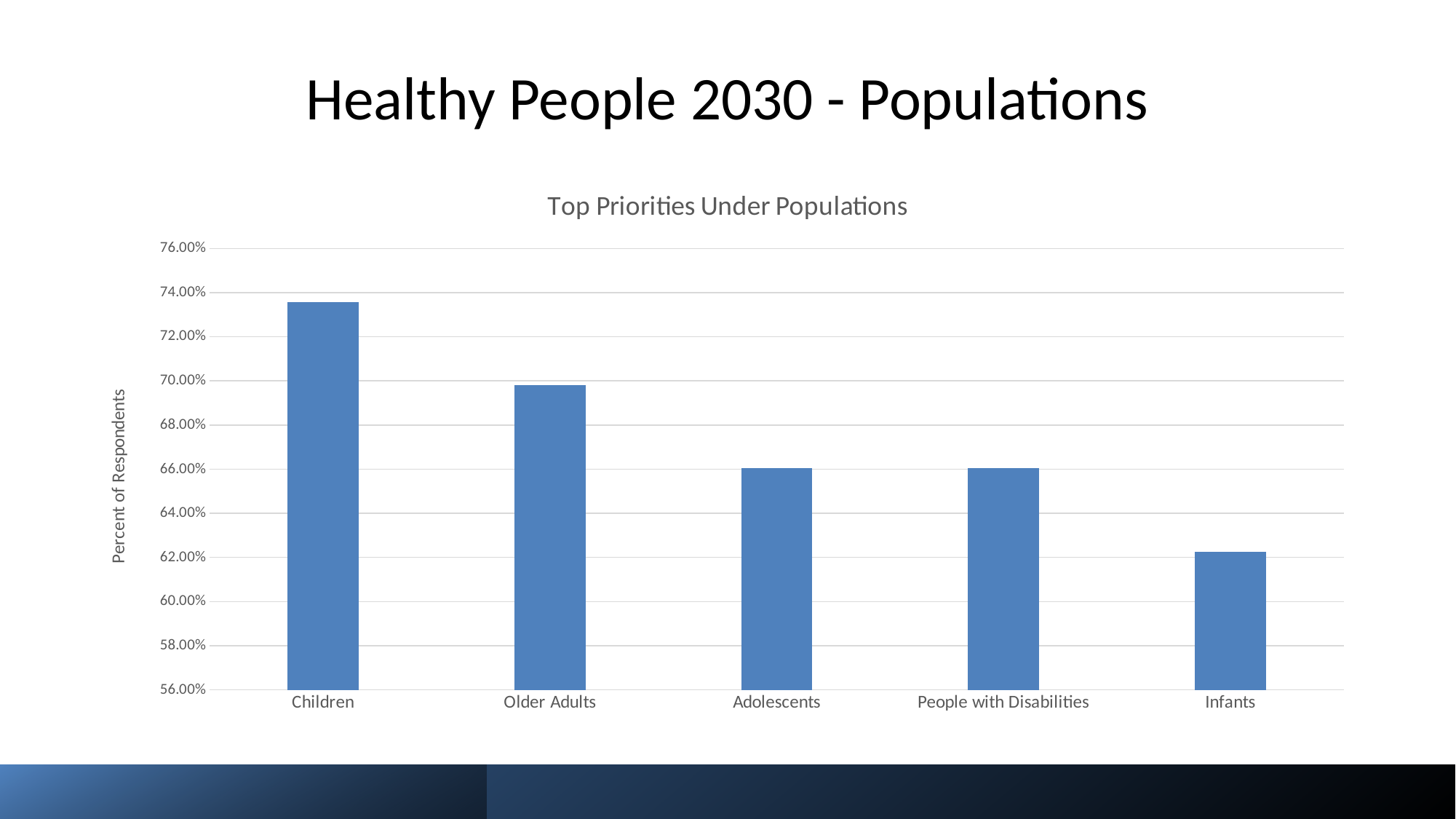
What is the label on the vertical axis of the chart? Percent of Respondents Which population has the highest percent of respondents? Children Do the values rise or fall moving from left to right across the categories? fall Which has a higher percent of respondents, Infants or Adolescents? Adolescents What kind of chart is shown on the slide? bar chart Which population has the lowest percent of respondents? Infants What is the title of the chart? Top Priorities Under Populations Is the value for Older Adults greater or less than 68.00%? greater Is the value for Children greater or less than 72.00%? greater Which has a higher percent of respondents, Children or Older Adults? Children How many population categories are plotted in the chart? 5 Is the value for Infants greater or less than 64.00%? less